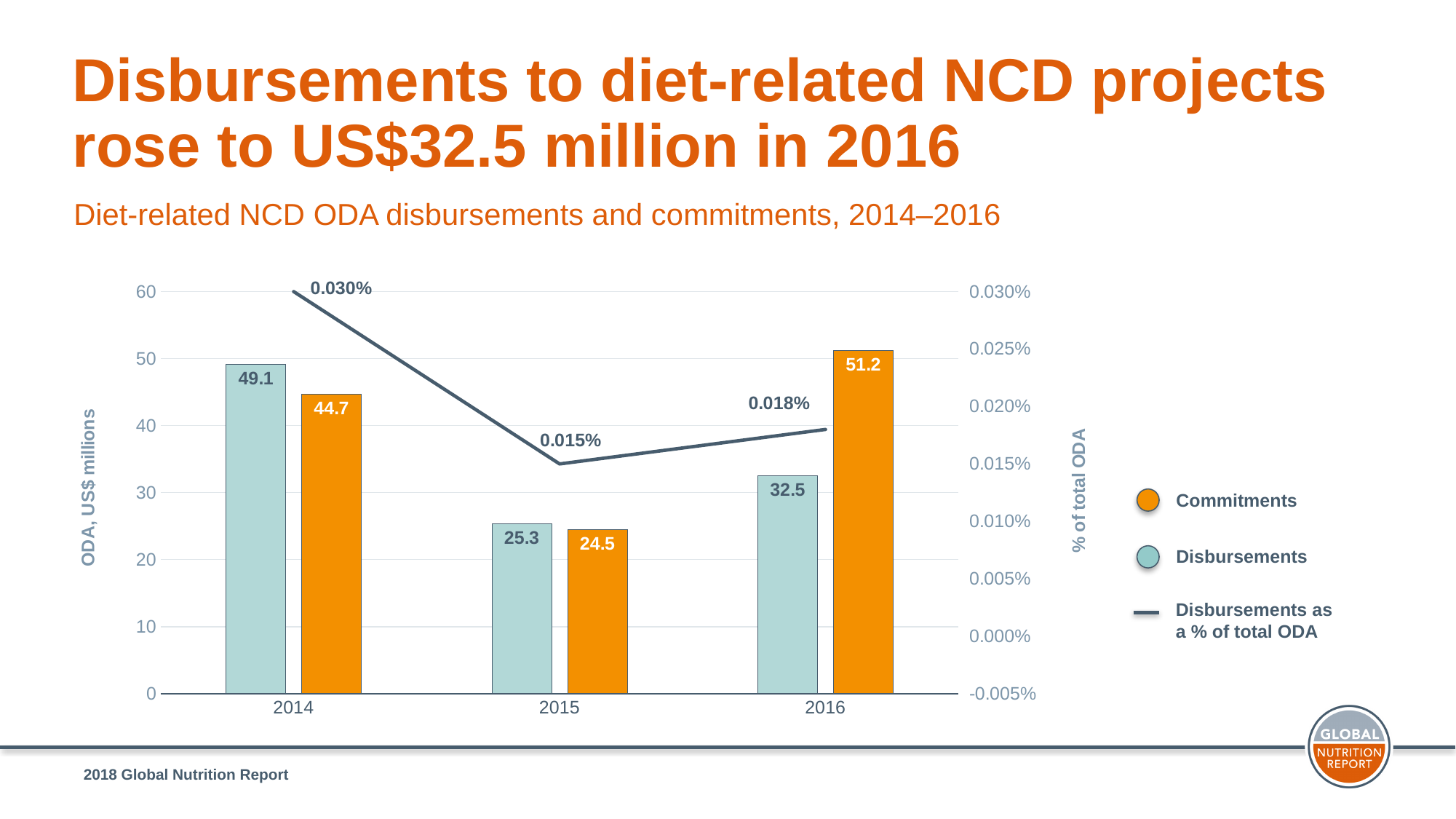
How many years are shown on the x axis? 3 What is the difference between Commitments and Disbursements in 2016? 18.7 In which year were Disbursements lowest? 2015 What was the value of Commitments in 2014? 44.7 In which year were Commitments highest? 2016 What was the value of Disbursements in 2016? 32.5 What kind of chart is used for Commitments and Disbursements? Bar chart Did Disbursements as a % of total ODA rise or fall from 2014 to 2015? Fall How many series does the legend list? 3 Which was larger in 2014, Disbursements or Commitments? Disbursements What is the label of the left vertical axis? ODA, US$ millions What was Disbursements as a % of total ODA in 2015? 0.015%